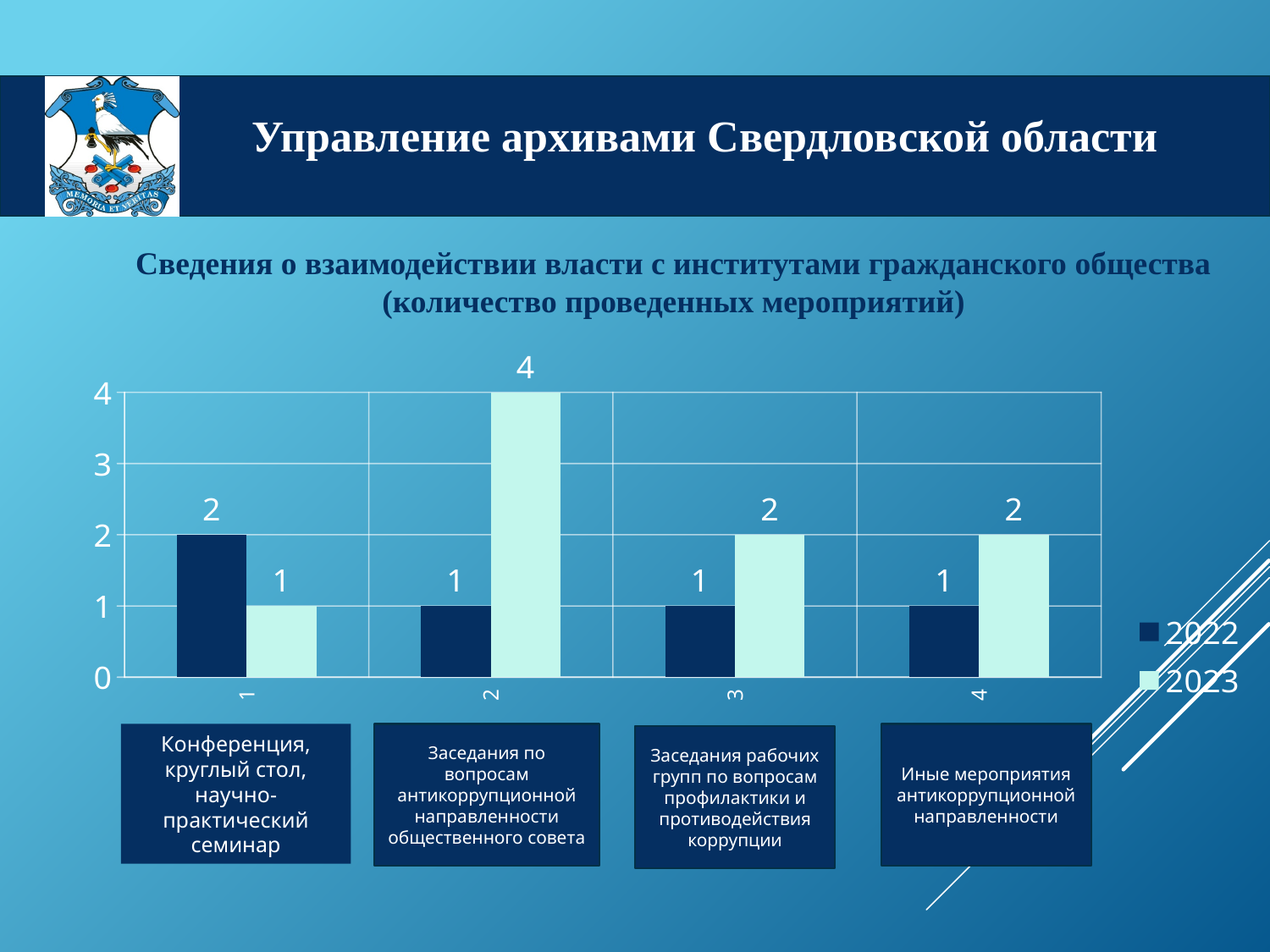
What is the 2022 value for category 1 (Конференция, круглый стол, научно-практический семинар)? 2 What type of chart is shown on the slide? bar chart What is the 2023 value for category 4 (Иные мероприятия антикоррупционной направленности)? 2 Which category has the highest 2023 value? 2 How many categories are shown on the x axis of the chart? 4 For category 1, which is larger: the 2022 value or the 2023 value? 2022 What is the difference between the 2023 and 2022 values for category 2? 3 How many series does the legend list? 2 Which series is shown in dark blue in the legend? 2022 What is the 2022 value for category 3 (Заседания рабочих групп по вопросам профилактики и противодействия коррупции)? 1 What is the 2023 value for category 2 (Заседания по вопросам антикоррупционной направленности общественного совета)? 4 Which category has the highest 2022 value? 1